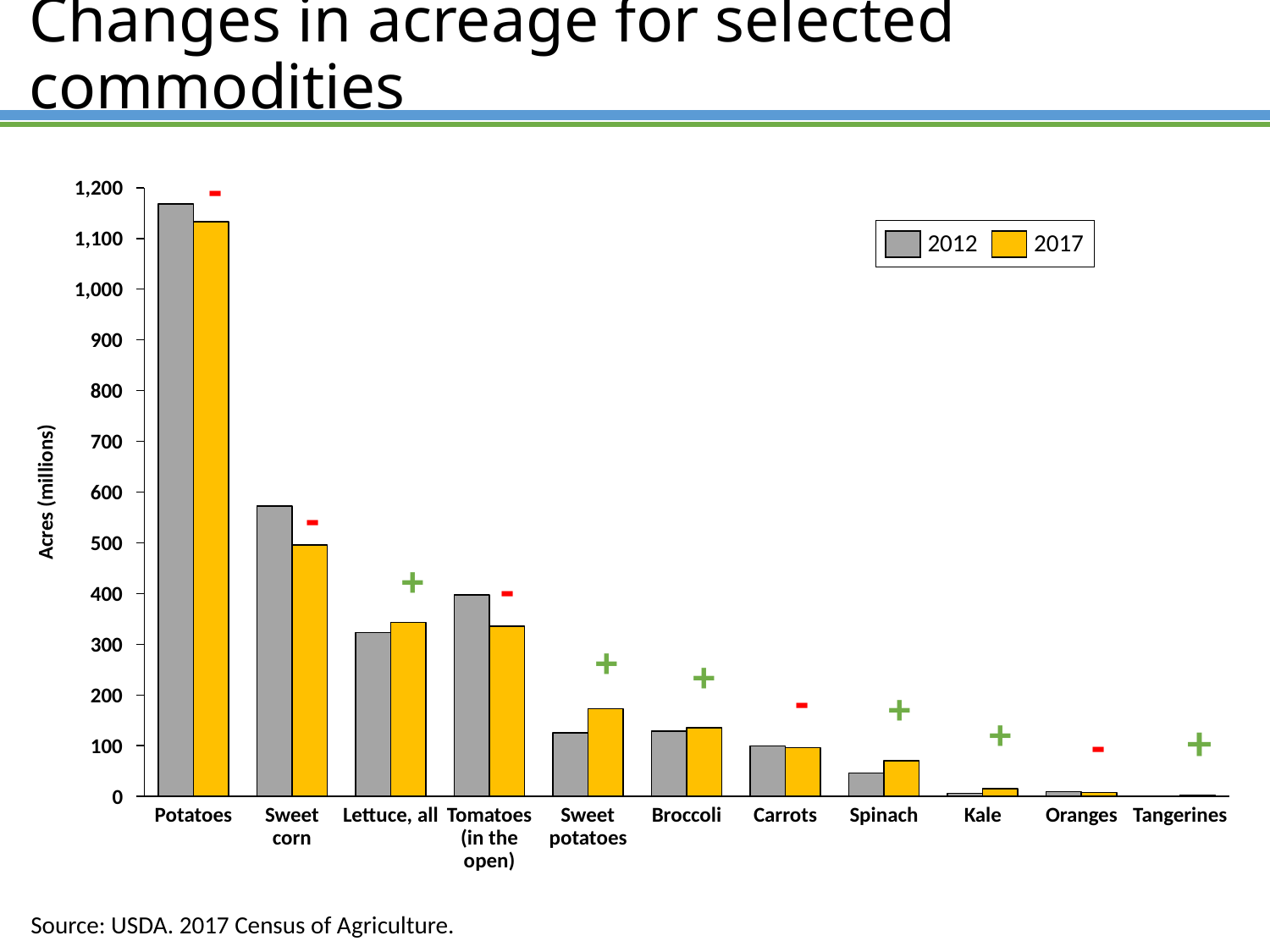
How many series does the legend list? 2 For Sweet corn, which year has the larger acreage, 2012 or 2017? 2012 Is the 2012 value for Potatoes greater or less than 1,100? greater What kind of chart is shown on the slide? Bar chart Which commodity has the lowest acreage in 2017? Tangerines For Sweet potatoes, which year has the larger acreage, 2012 or 2017? 2017 Is the 2017 value for Spinach greater or less than 100? less What is the label on the vertical axis? Acres (millions) How many commodities are shown on the x axis? 11 Which commodity has the highest acreage in 2012? Potatoes Is the 2017 value for Sweet corn greater or less than 600? less